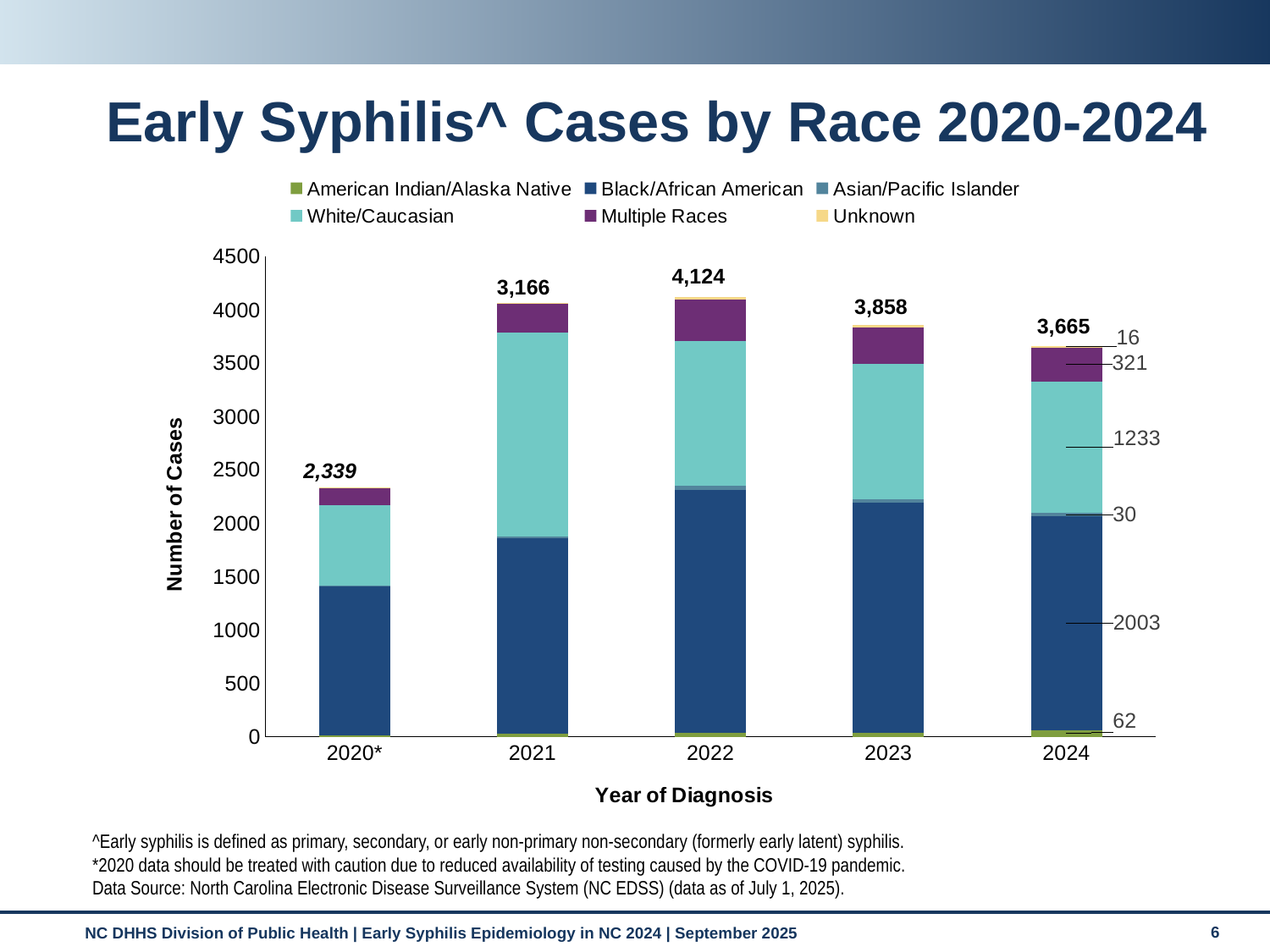
How many early syphilis cases were among White/Caucasian persons in 2024? 1233 What kind of chart is shown on the slide? Stacked bar chart How many early syphilis cases were among Black/African American persons in 2024? 2003 In 2024, how many more cases were among Black/African American persons than among White/Caucasian persons? 770 What is the total number of early syphilis cases shown for 2020*? 2,339 How many race categories does the legend list? 6 Which year has the lowest total number of early syphilis cases? 2020* Which year has the highest total number of early syphilis cases? 2022 Which year had more total early syphilis cases, 2023 or 2024? 2023 What is the total number of early syphilis cases shown for 2022? 4,124 What is the difference between the total cases in 2022 and the total cases in 2023? 266 How many early syphilis cases were among persons of Multiple Races in 2024? 321